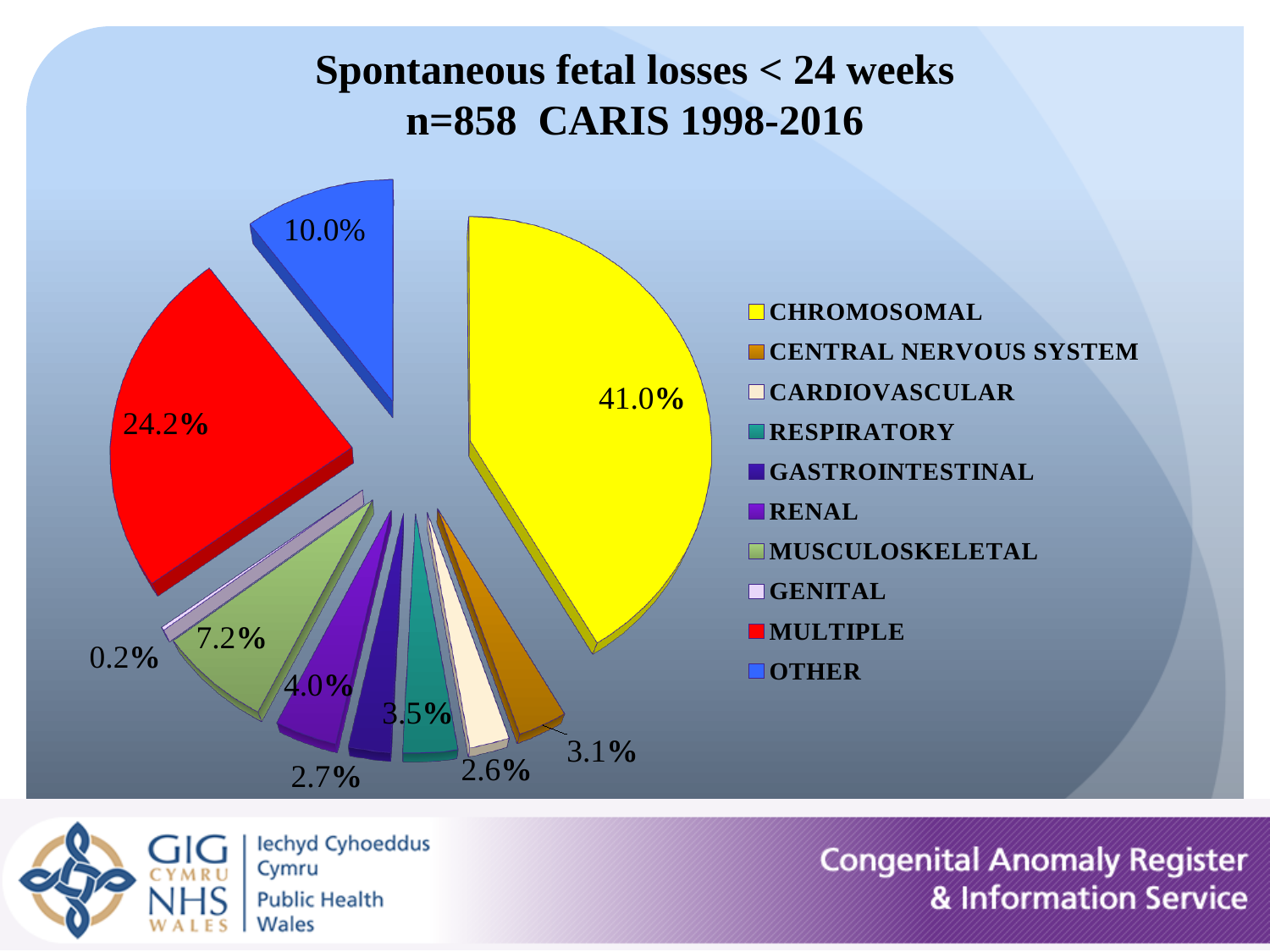
What percentage is shown for Musculoskeletal? 7.2% What is the difference in percentage points between the Chromosomal and Multiple slices? 16.8 Which category has the smallest share of the pie? Genital What percentage is shown for the Other category? 10.0% Which category has the largest share of the pie? Chromosomal What is the value of n stated in the chart title? 858 How many categories does the legend list? 10 Which is larger, the Renal slice or the Respiratory slice? Renal What percentage is shown for Genital? 0.2% What type of chart is shown on the slide? pie chart What percentage of spontaneous fetal losses is attributed to chromosomal anomalies? 41.0% What percentage is shown for the Multiple category? 24.2%